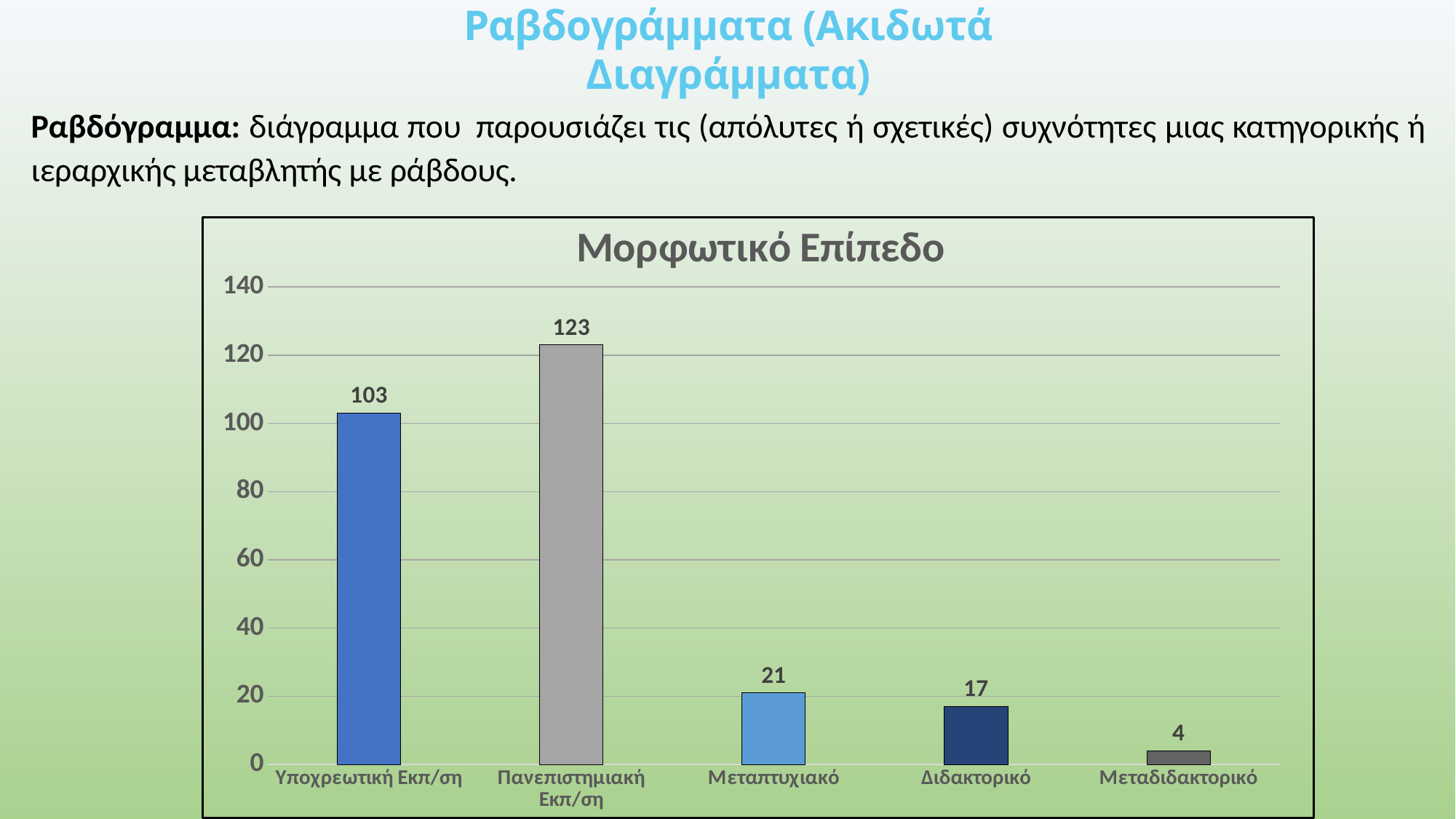
What is the difference between the values for Μεταπτυχιακό and Διδακτορικό? 4 What is the difference between the values for Πανεπιστημιακή Εκπ/ση and Υποχρεωτική Εκπ/ση? 20 What is the value for Πανεπιστημιακή Εκπ/ση? 123 What is the value for Μεταδιδακτορικό? 4 What is the value for Μεταπτυχιακό? 21 What is the title of the chart? Μορφωτικό Επίπεδο How many categories are shown in the chart? 5 Which category has the highest value? Πανεπιστημιακή Εκπ/ση Is the value for Υποχρεωτική Εκπ/ση greater or less than 100? greater Which category has the lowest value? Μεταδιδακτορικό Which is larger, the value for Διδακτορικό or the value for Μεταπτυχιακό? Μεταπτυχιακό What is the value for Υποχρεωτική Εκπ/ση? 103